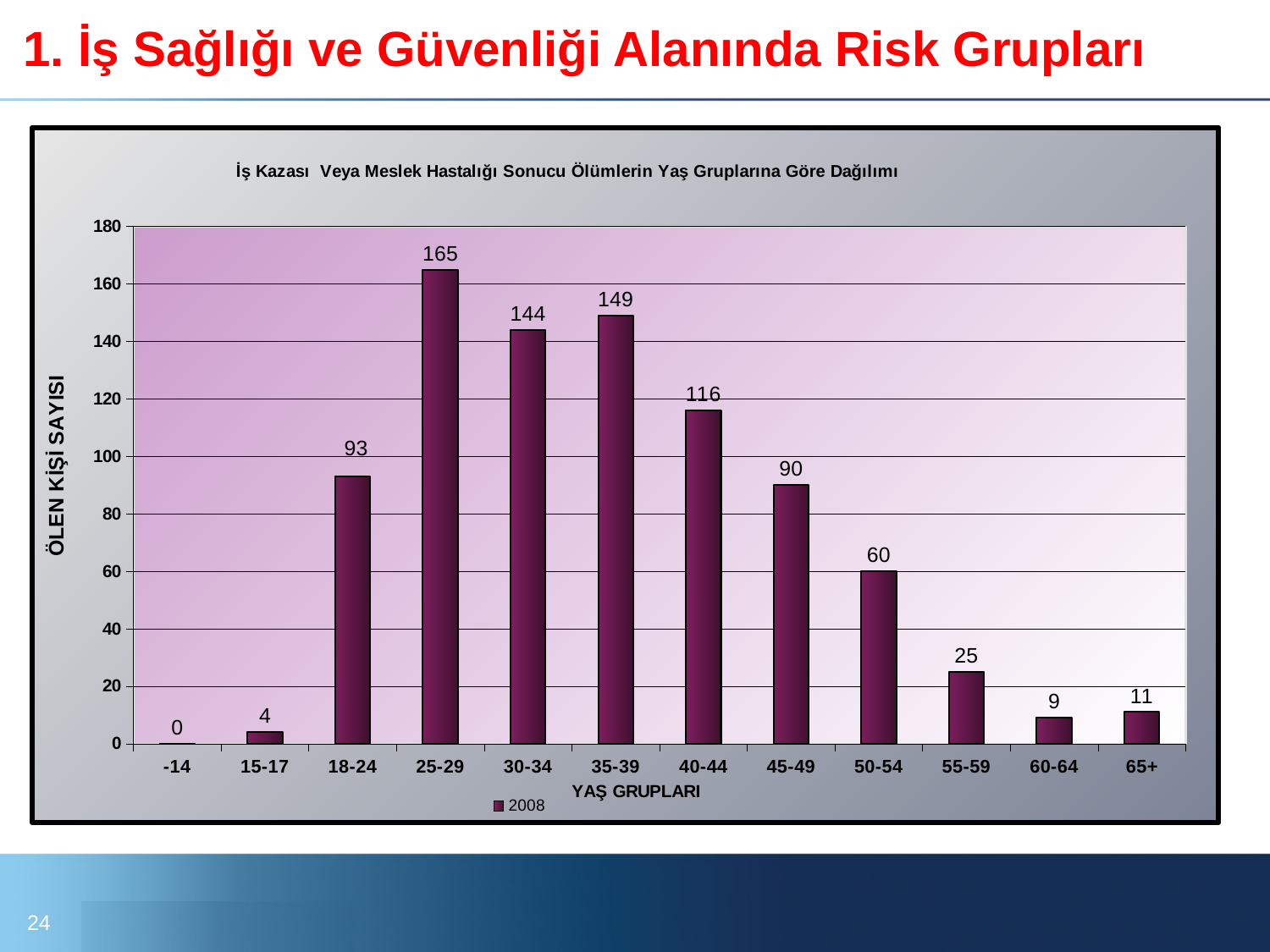
What is the difference between the values for 18-24 and 50-54? 33 What is the difference between the values for 35-39 and 30-34? 5 Which age group has the highest number of deaths? 25-29 How many age groups are shown on the x axis? 12 What kind of chart is shown? bar chart What year does the legend entry show? 2008 What is the value for the 60-64 age group? 9 Which age group has the lowest number of deaths? -14 Which is larger, the value for 45-49 or the value for 55-59? 45-49 What is the value for the 25-29 age group? 165 What is the value for the 40-44 age group? 116 How many series does the legend list? 1